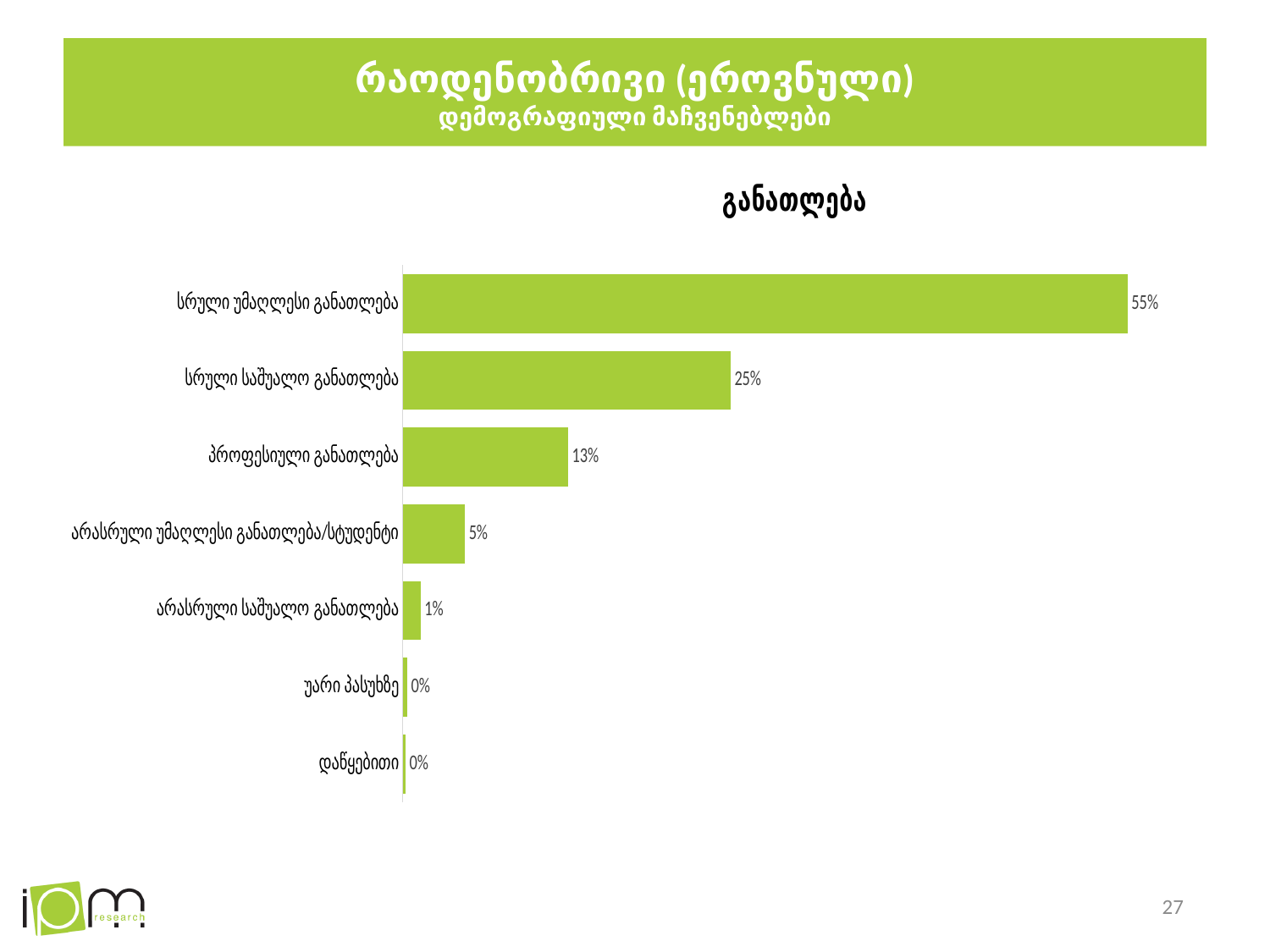
What is the difference between პროფესიული განათლება and არასრული უმაღლესი განათლება/სტუდენტი? 8% What is the value for სრული უმაღლესი განათლება? 55% What is the difference between სრული უმაღლესი განათლება and სრული საშუალო განათლება? 30% What is the title of the chart? განათლება What kind of chart is shown? Bar chart What is the value for არასრული საშუალო განათლება? 1% How many categories are shown in the chart? 7 What is the value for სრული საშუალო განათლება? 25% Which is larger, სრული საშუალო განათლება or პროფესიული განათლება? სრული საშუალო განათლება What is the value for პროფესიული განათლება? 13% What is the value for არასრული უმაღლესი განათლება/სტუდენტი? 5% Which category has the highest value? სრული უმაღლესი განათლება